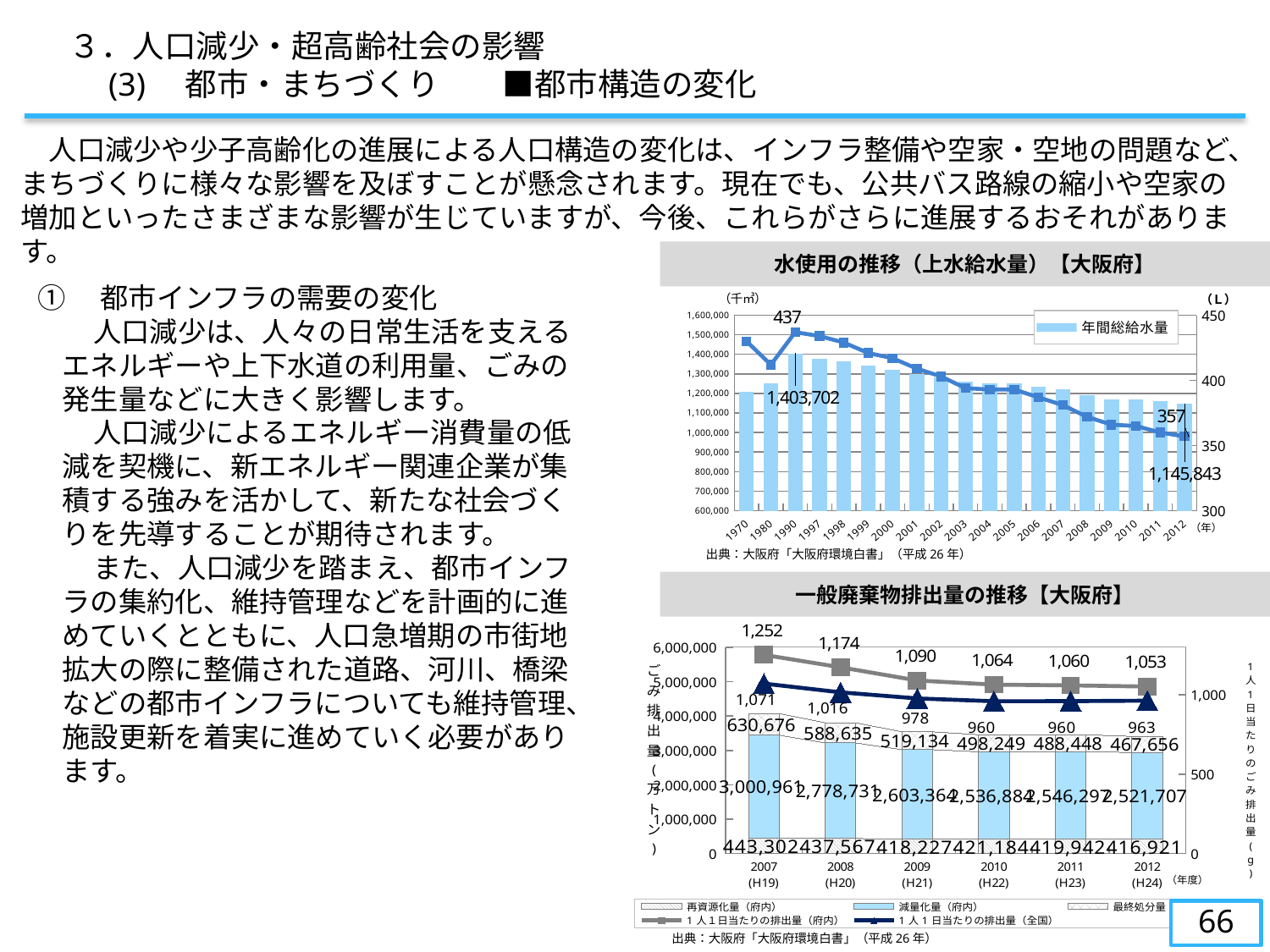
In the chart titled 一般廃棄物排出量の推移【大阪府】, which year has the lowest 1人1日当たりの排出量（府内） value? 2012 In the chart titled 水使用の推移（上水給水量）【大阪府】, how many years are shown on the x axis? 19 In the chart titled 一般廃棄物排出量の推移【大阪府】, how many series does the legend list? 5 In the chart titled 水使用の推移（上水給水量）【大阪府】, what is the difference between the labelled line values 437 and 357? 80 In the chart titled 一般廃棄物排出量の推移【大阪府】, what is the difference between the 1人1日当たりの排出量（府内） values for 2007 and 2012? 199 In the chart titled 一般廃棄物排出量の推移【大阪府】, what is the total of the stacked bar for 2007? 4,074,939 In the chart titled 水使用の推移（上水給水量）【大阪府】, what is the value of the line series labelled at 1990? 437 In the chart titled 一般廃棄物排出量の推移【大阪府】, what is the 1人1日当たりの排出量（府内） value for 2007? 1,252 In the chart titled 水使用の推移（上水給水量）【大阪府】, what is the 年間総給水量 value labelled for 2012? 1,145,843 In the chart titled 一般廃棄物排出量の推移【大阪府】, what is the 減量化量（府内） value for 2012? 2,521,707 In the chart titled 水使用の推移（上水給水量）【大阪府】, what is the value of the line series labelled at 2012? 357 In the chart titled 水使用の推移（上水給水量）【大阪府】, does the line series rise or fall from 1997 to 2012? fall